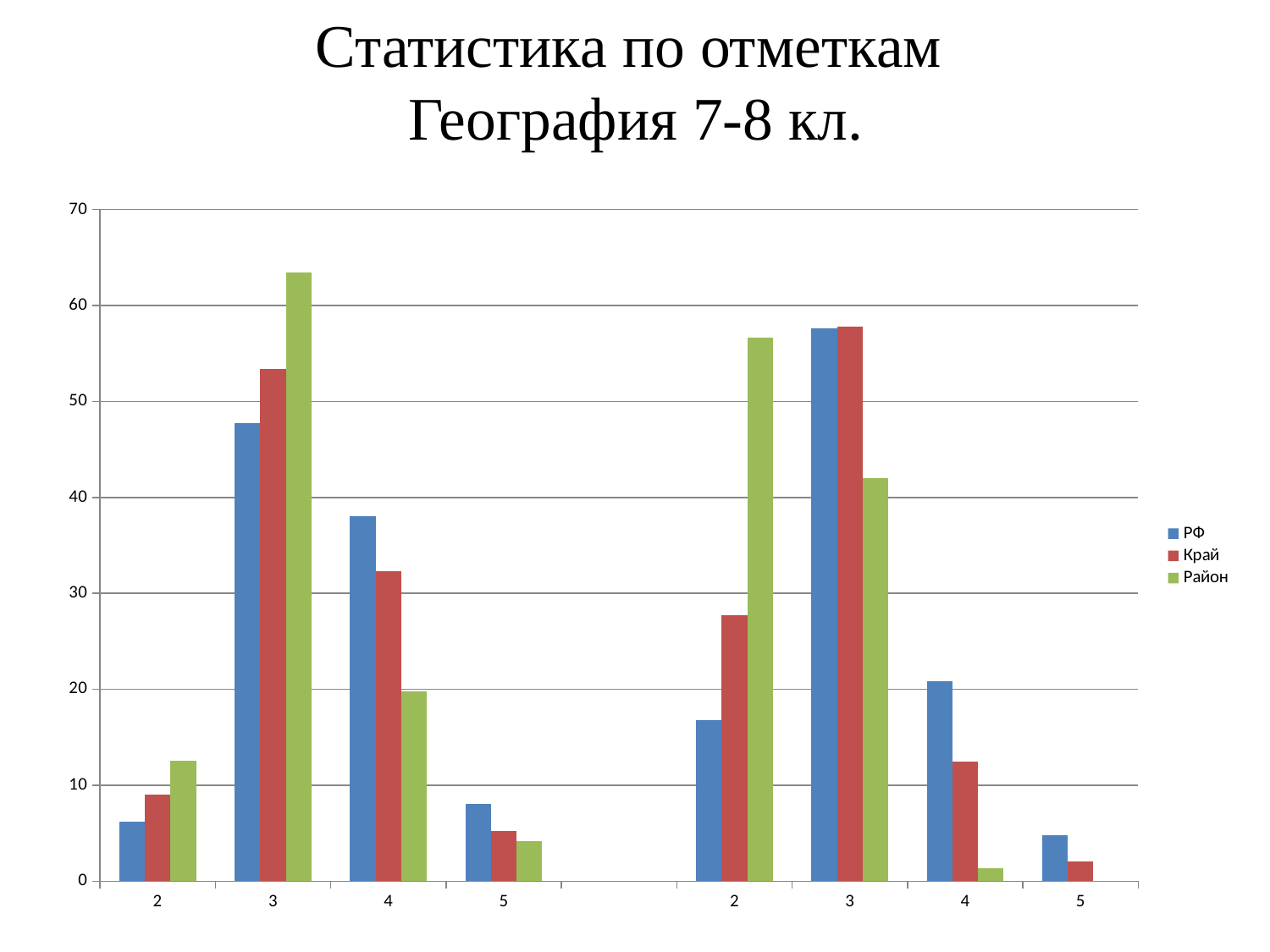
In the right group of categories, which is larger for category 2: Край or Район? Район What are the three series named in the legend? РФ, Край, Район In the left group of categories, which category has the highest Район value? 3 In the left group of categories, which is larger for category 3: РФ or Район? Район How many series does the legend list? 3 What kind of chart is shown on the slide? bar chart In the left group of categories, is the Район value for category 3 greater or less than 60? greater In the left group of categories, is the РФ value for category 4 greater or less than 30? greater In the right group of categories, which category has the lowest Край value? 5 In the right group of categories, do the Район values rise or fall from category 2 to category 5? fall In the right group of categories, is the Район value for category 2 greater or less than 50? greater What is the title of the chart on the slide? Статистика по отметкам География 7-8 кл.